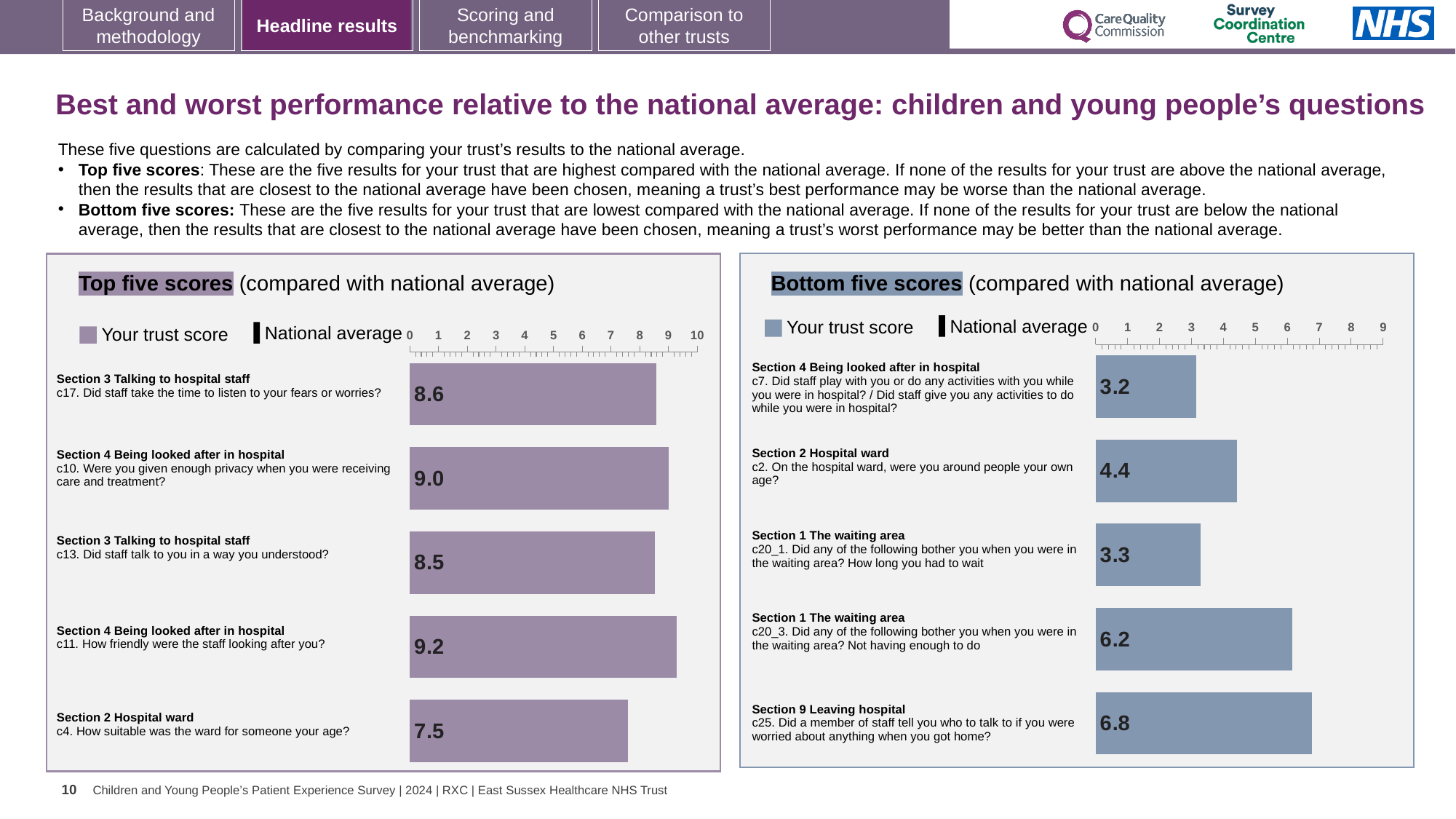
In the Top five scores chart, what is the trust score for c11. How friendly were the staff looking after you? 9.2 In the Bottom five scores chart, which question has the lowest trust score? c7. Did staff play with you or do any activities with you while you were in hospital? In the Bottom five scores chart, which has the larger trust score: c2 (around people your own age) or c20_1 (how long you had to wait)? c2 (around people your own age) In the Top five scores chart, which question has the highest trust score? c11. How friendly were the staff looking after you? What kind of chart is the Bottom five scores chart? Bar chart In the Bottom five scores chart, which question has the highest trust score? c25. Did a member of staff tell you who to talk to if you were worried about anything when you got home? In the Bottom five scores chart, what is the difference between the trust scores for c20_3 (not having enough to do) and c7 (staff play or activities)? 3.0 How many entries does the legend of the Top five scores chart list? 2 In the Top five scores chart, which question has the lowest trust score? c4. How suitable was the ward for someone your age? How many questions are plotted in the Top five scores chart? 5 In the Top five scores chart, what is the difference between the trust scores for c10 (enough privacy) and c4 (ward suitable for your age)? 1.5 In the Bottom five scores chart, what is the trust score for c25. Did a member of staff tell you who to talk to if you were worried about anything when you got home? 6.8